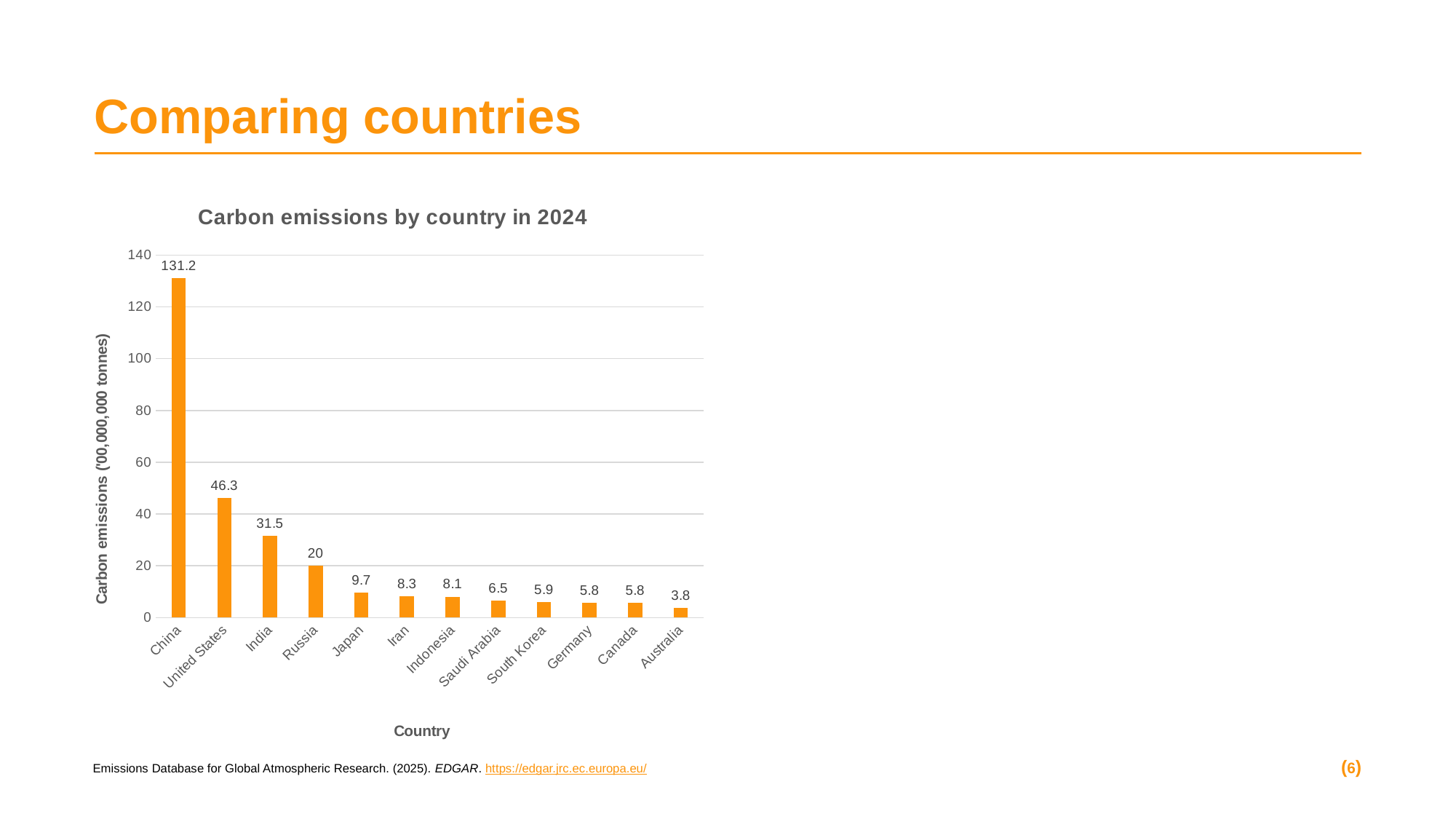
What is the difference between the values for China and the United States? 84.9 What is the value for Saudi Arabia? 6.5 What is the title of the chart? Carbon emissions by country in 2024 What is the value for China? 131.2 Which country has the highest carbon emissions? China Is the value for the United States greater or less than 40? greater Which country has the lowest carbon emissions? Australia What kind of chart is shown on the slide? Bar chart Which is larger, the value for Russia or the value for Japan? Russia What is the value for India? 31.5 What is the difference between the values for Japan and Australia? 5.9 How many countries are shown in the chart? 12